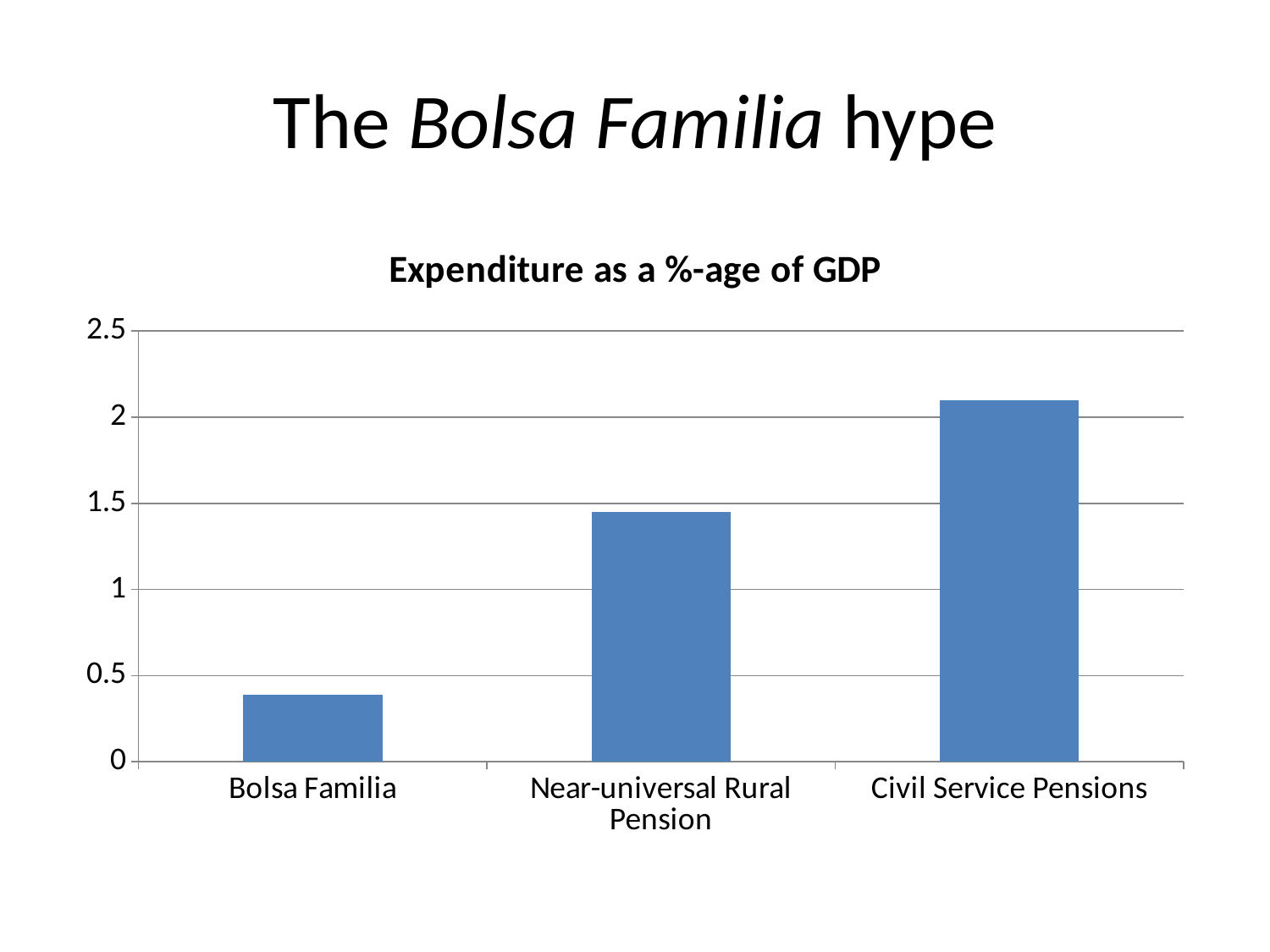
What is the highest value shown on the vertical axis? 2.5 What kind of chart is shown on the slide? bar chart Which category has the highest expenditure as a %-age of GDP? Civil Service Pensions Is the value for Near-universal Rural Pension greater or less than 1? greater Which category has the lowest expenditure as a %-age of GDP? Bolsa Familia Which is larger, the value for Bolsa Familia or the value for Civil Service Pensions? Civil Service Pensions Do the values rise or fall from left to right along the x axis? rise Is the value for Near-universal Rural Pension greater or less than 1.5? less Is the value for Bolsa Familia greater or less than 0.5? less How many categories are shown on the x axis? 3 What is the title of the chart? Expenditure as a %-age of GDP